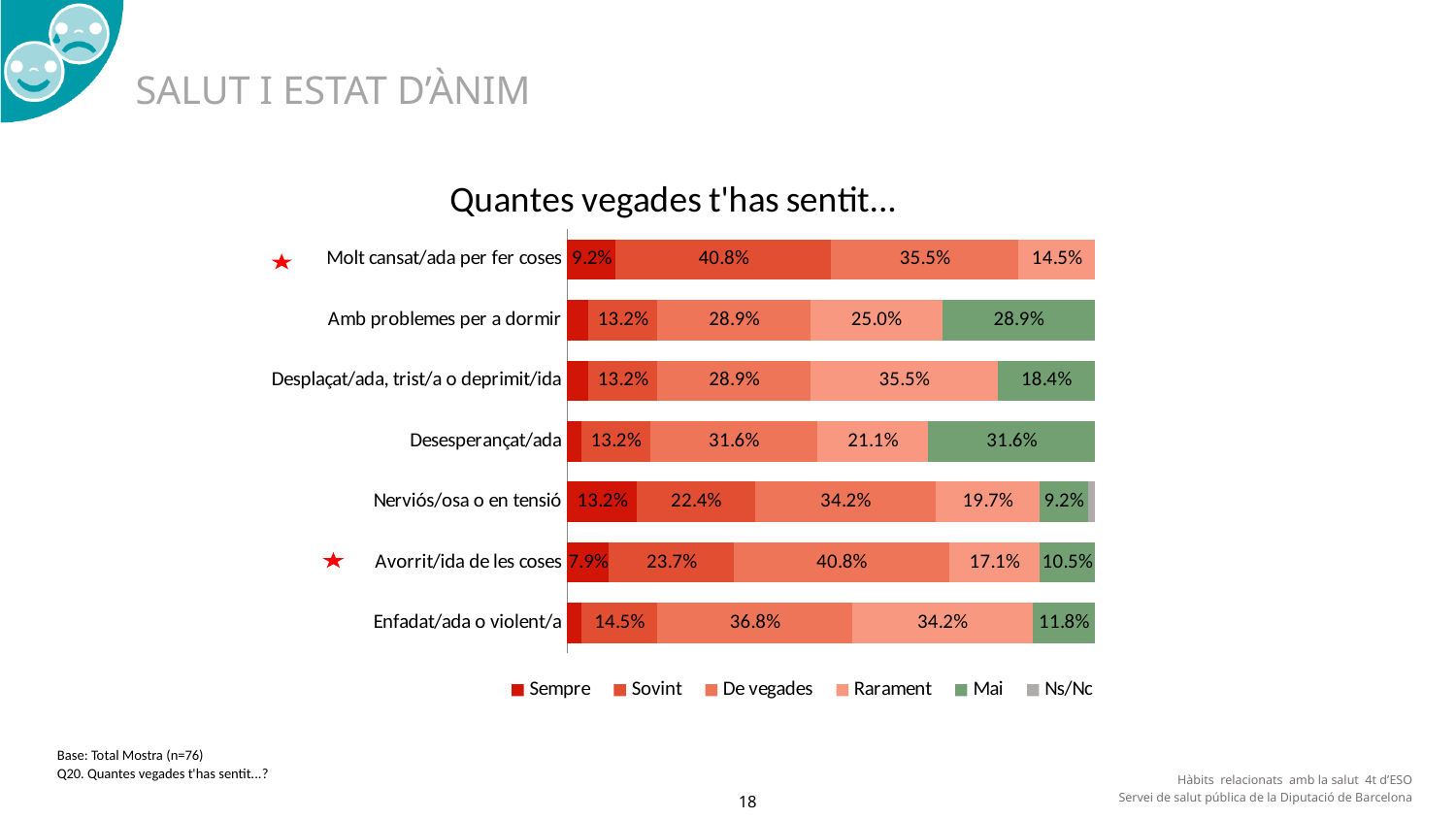
What is the 'Mai' value for 'Amb problemes per a dormir'? 28.9% What is the 'Sovint' value for 'Molt cansat/ada per fer coses'? 40.8% Which is larger: the 'Sovint' value for 'Nerviós/osa o en tensió' or the 'Sovint' value for 'Avorrit/ida de les coses'? Avorrit/ida de les coses What is the title of the chart? Quantes vegades t'has sentit... What is the 'Rarament' value for 'Desplaçat/ada, trist/a o deprimit/ida'? 35.5% What is the 'De vegades' value for 'Avorrit/ida de les coses'? 40.8% How many categories (feelings) are listed on the chart? 7 What is the 'Sempre' value for 'Nerviós/osa o en tensió'? 13.2% How many series does the legend list? 6 What is the difference between the 'De vegades' value for 'Enfadat/ada o violent/a' and the 'Rarament' value for the same category? 2.6% What type of chart is shown on the slide? Stacked bar chart Which category has the highest 'Mai' value? Desesperançat/ada